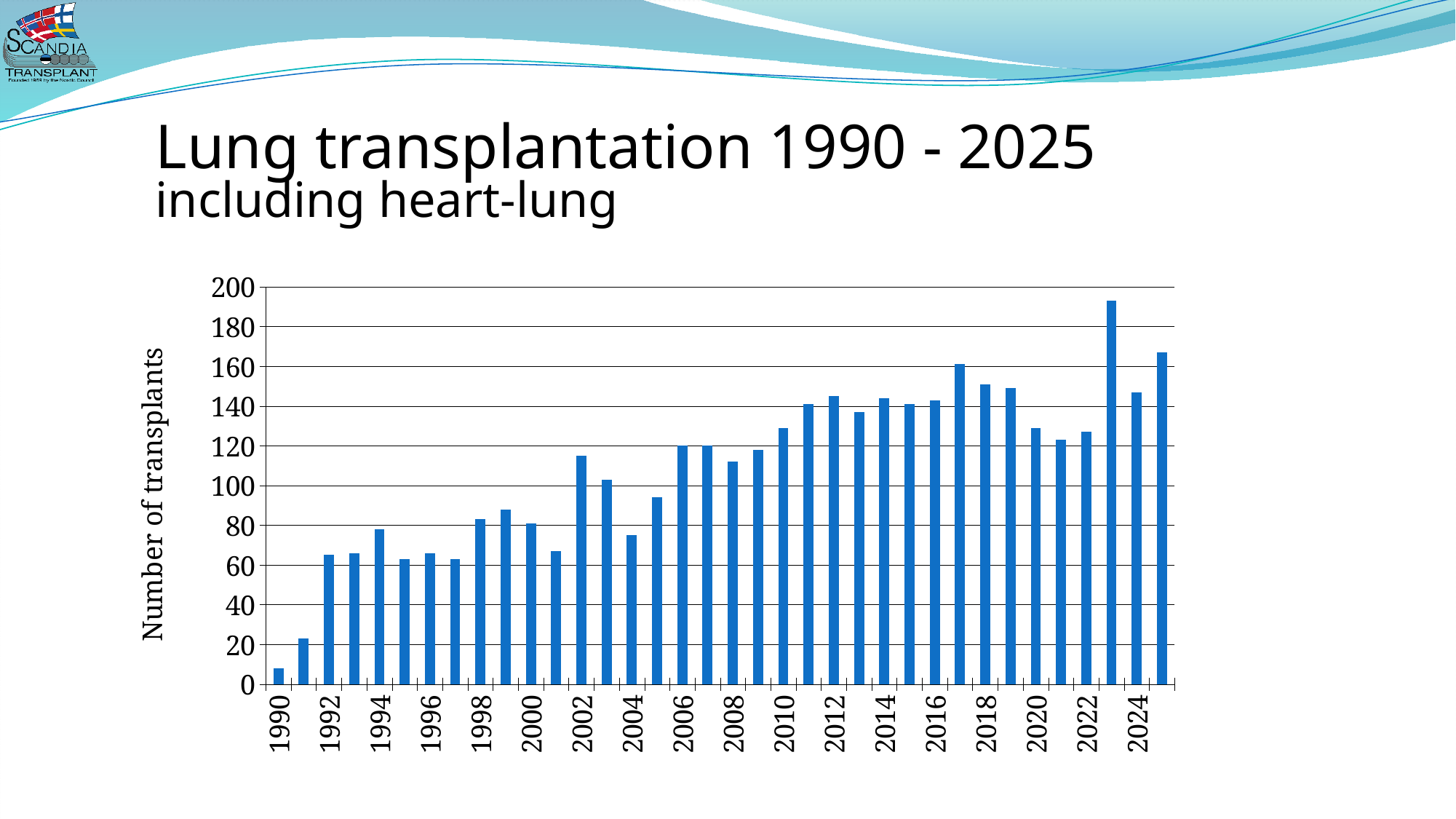
Which year has more transplants, 2002 or 2004? 2002 How many years (bars) are plotted in the chart? 36 Is the value for 1990 greater or less than 20? less Is the value for 2002 greater or less than 100? greater Is the value for 2004 greater or less than 80? less Which year has more transplants, 2023 or 2025? 2023 Which year has the highest number of transplants? 2023 What kind of chart is shown on the slide? bar chart Overall, do the number of transplants rise or fall from 1990 to 2025? rise What is the label on the vertical axis of the chart? Number of transplants Which year has the lowest number of transplants? 1990